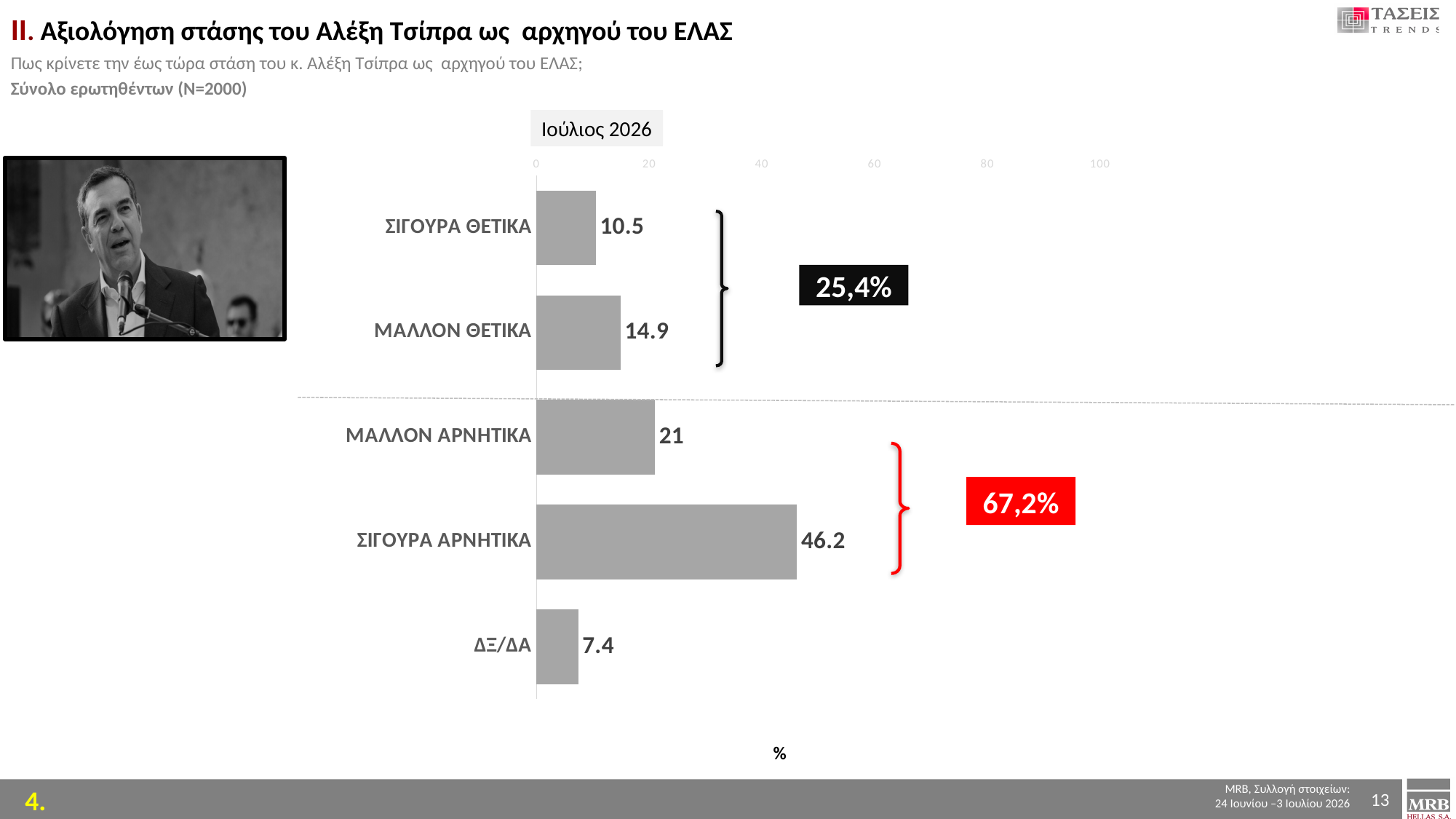
Is the value for ΣΙΓΟΥΡΑ ΑΡΝΗΤΙΚΑ greater or less than 40? greater What is the difference between the values for ΣΙΓΟΥΡΑ ΑΡΝΗΤΙΚΑ and ΜΑΛΛΟΝ ΑΡΝΗΤΙΚΑ? 25.2 Which category has the lowest value? ΔΞ/ΔΑ What is the value for ΔΞ/ΔΑ? 7.4 What combined percentage is shown in the red box next to the negative categories? 67,2% How many categories are shown in the chart? 5 Which is larger, the value for ΜΑΛΛΟΝ ΘΕΤΙΚΑ or the value for ΜΑΛΛΟΝ ΑΡΝΗΤΙΚΑ? ΜΑΛΛΟΝ ΑΡΝΗΤΙΚΑ What is the value for ΜΑΛΛΟΝ ΘΕΤΙΚΑ? 14.9 What kind of chart is shown on the slide? bar chart Which category has the highest value? ΣΙΓΟΥΡΑ ΑΡΝΗΤΙΚΑ What is the value for ΣΙΓΟΥΡΑ ΑΡΝΗΤΙΚΑ? 46.2 What is the value for ΣΙΓΟΥΡΑ ΘΕΤΙΚΑ? 10.5